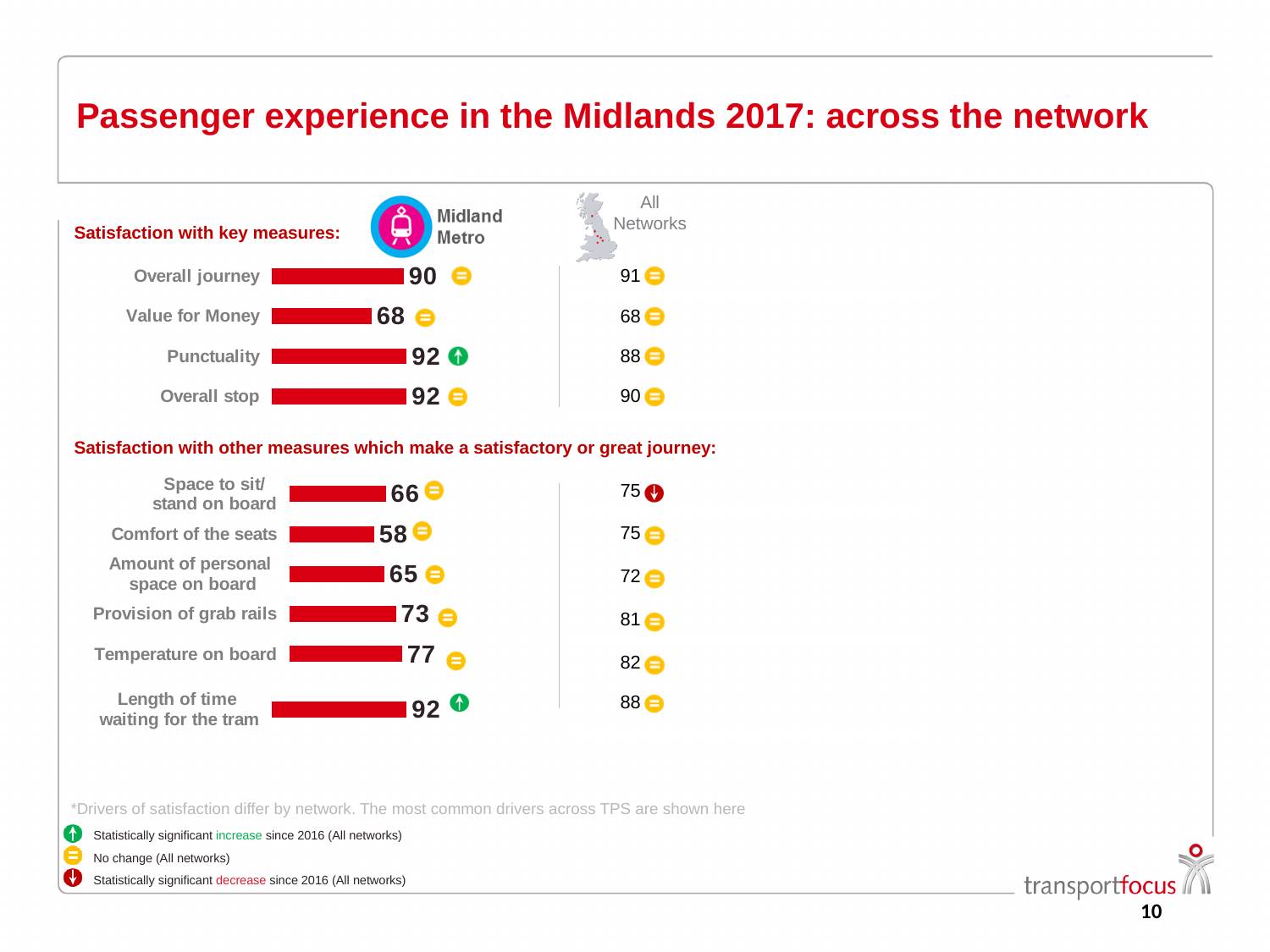
In the 'Satisfaction with key measures' chart, which measure has the lowest Midland Metro value? Value for Money In the 'Satisfaction with other measures' chart, what is the difference between the All Networks and Midland Metro values for Comfort of the seats? 17 In the 'Satisfaction with other measures' chart, which measure has the lowest Midland Metro value? Comfort of the seats In the 'Satisfaction with other measures' chart, which measure has the highest Midland Metro value? Length of time waiting for the tram In the 'Satisfaction with other measures' chart, what is the Midland Metro value for Comfort of the seats? 58 In the 'Satisfaction with other measures' chart, is the Midland Metro value for Temperature on board larger or smaller than the All Networks value? smaller In the 'Satisfaction with other measures' chart, what is the All Networks value for Provision of grab rails? 81 What type of chart is used to show the Midland Metro satisfaction values? bar chart In the 'Satisfaction with key measures' chart, what is the difference between the Midland Metro and All Networks values for Punctuality? 4 In the 'Satisfaction with key measures' chart, what is the All Networks value for Punctuality? 88 In the 'Satisfaction with key measures' chart, what is the Midland Metro value for Overall journey? 90 In the 'Satisfaction with key measures' chart, how many measures are shown? 4